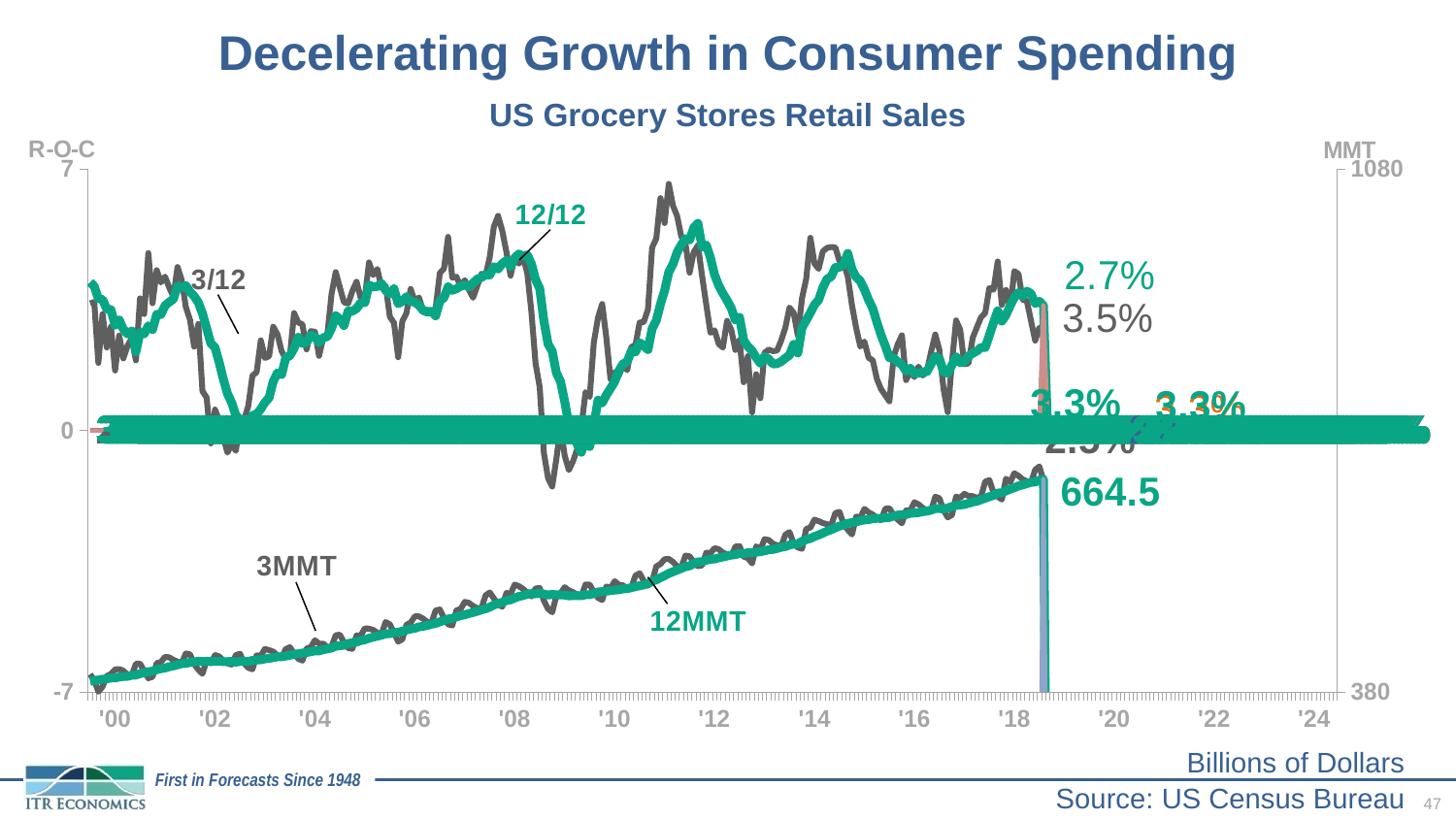
How many labeled data series are plotted on the chart (3/12, 12/12, 3MMT, 12MMT)? 4 What is the title of the chart on the slide? US Grocery Stores Retail Sales Is the 12/12 rate-of-change value at the end of the series greater or less than 0? greater Does the 12MMT line generally rise or fall from '00 to '18? rise What is the maximum value shown on the left R-O-C axis? 7 What kind of chart is shown on the slide? line chart What is the latest 12MMT value labeled on the chart? 664.5 In what units are the MMT values on the chart expressed? Billions of Dollars